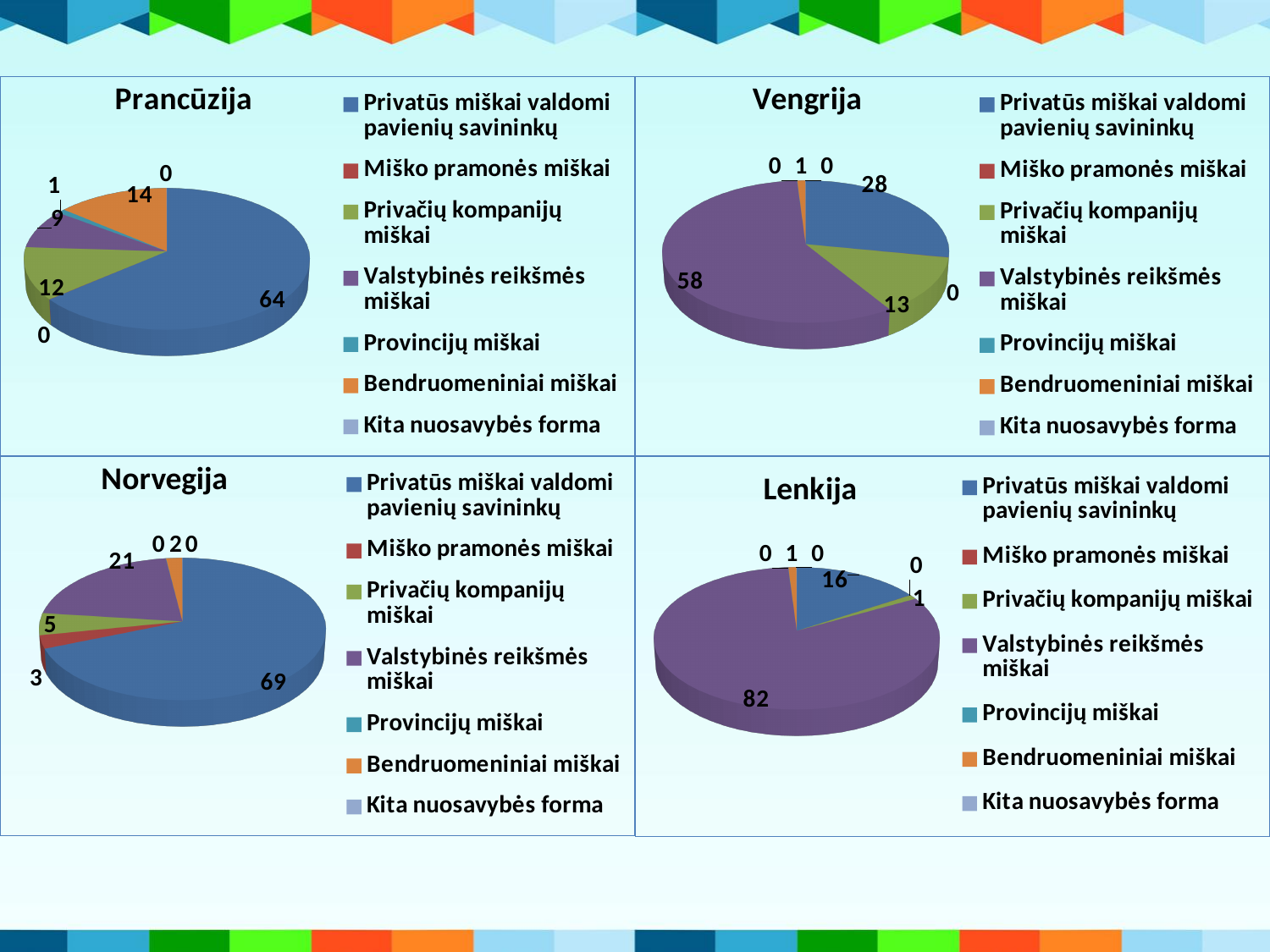
In the Norvegija chart, what is the difference between Privatūs miškai valdomi pavienių savininkų and Valstybinės reikšmės miškai? 48 How many pie charts are shown on the slide? 4 In the Norvegija chart, what is the value for Privatūs miškai valdomi pavienių savininkų? 69 In the Lenkija chart, which is larger, Privatūs miškai valdomi pavienių savininkų or Valstybinės reikšmės miškai? Valstybinės reikšmės miškai In the Prancūzija chart, which is larger, Privačių kompanijų miškai or Bendruomeniniai miškai? Bendruomeniniai miškai How many entries does the legend of the Norvegija chart list? 7 In the Vengrija chart, which category has the largest slice? Valstybinės reikšmės miškai In the Prancūzija chart, what is the value for Bendruomeniniai miškai? 14 What kind of chart is the Vengrija chart? Pie chart In the Lenkija chart, what is the value for Valstybinės reikšmės miškai? 82 In the Vengrija chart, what is the value for Valstybinės reikšmės miškai? 58 In the Prancūzija chart, what is the value for Privatūs miškai valdomi pavienių savininkų? 64